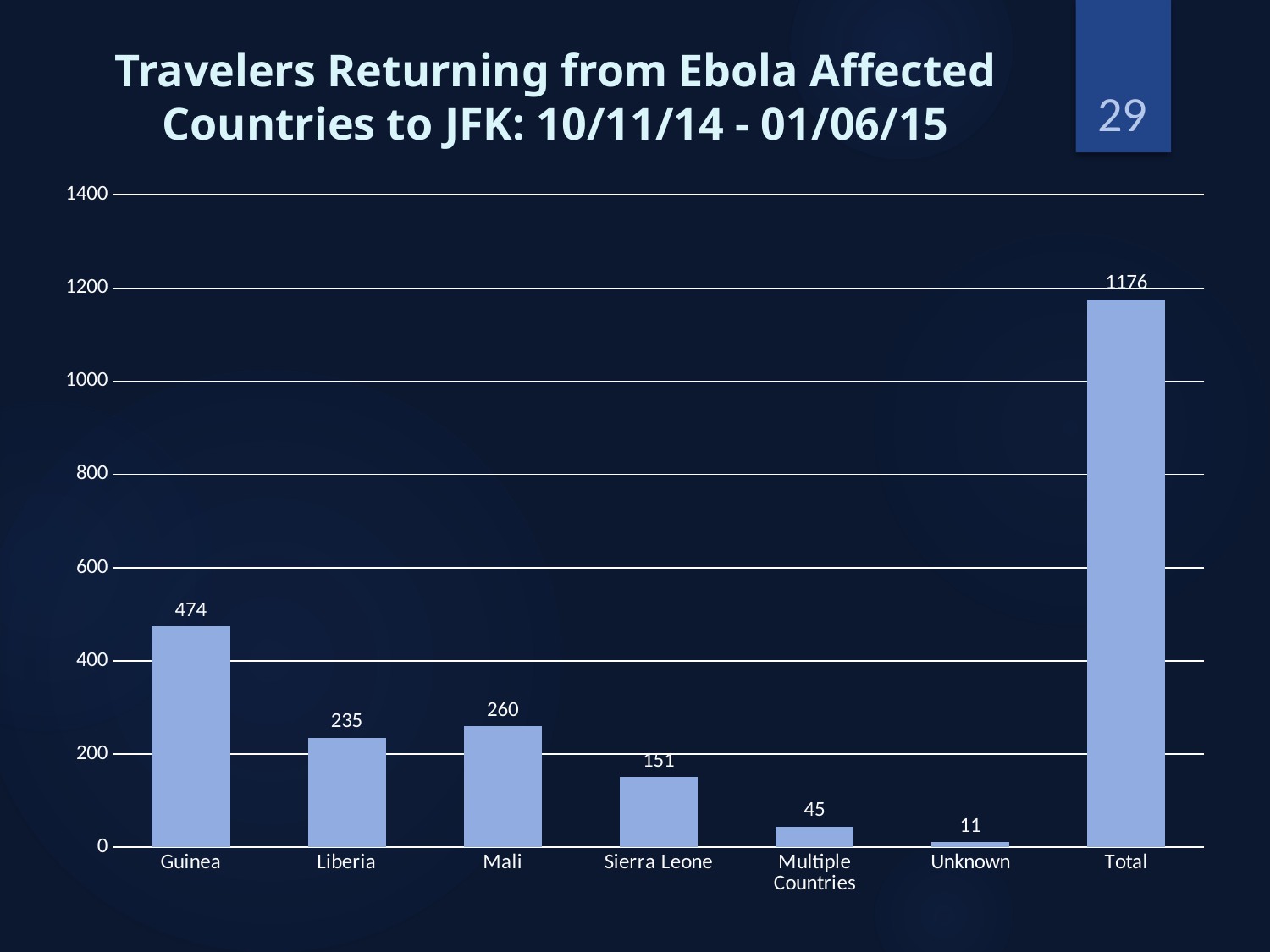
Which category has the lowest value? Unknown What kind of chart is shown on the slide? Bar chart What is the value for Guinea? 474 What is the value for Multiple Countries? 45 What is the title of the chart? Travelers Returning from Ebola Affected Countries to JFK: 10/11/14 - 01/06/15 Excluding the Total bar, which country has the highest number of travelers? Guinea Which is larger, the value for Liberia or the value for Mali? Mali What is the value for Mali? 260 What is the value for Unknown? 11 How many bars are shown in the chart? 7 What is the difference between the values for Mali and Sierra Leone? 109 What is the difference between the values for Guinea and Liberia? 239